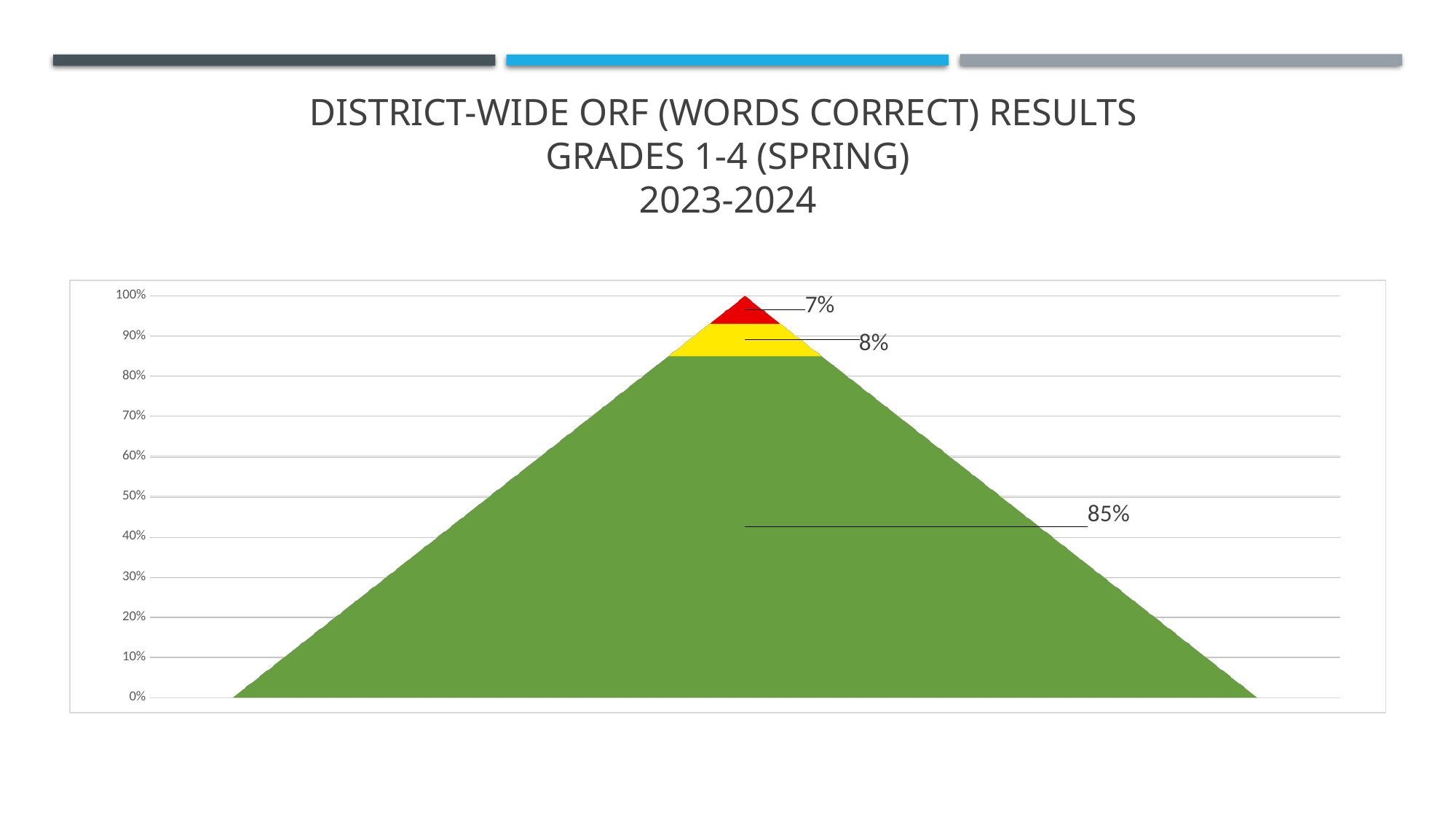
Which coloured segment has the largest value? green What is the difference between the yellow segment's value and the red segment's value? 1% What value is labelled on the red segment at the top of the pyramid? 7% What value is labelled on the green segment of the pyramid? 85% What school year does the chart title refer to? 2023-2024 How many coloured segments make up the pyramid? 3 What is the difference between the green segment's value and the yellow segment's value? 77% What is the highest value shown on the vertical axis? 100% What value is labelled on the yellow segment of the pyramid? 8% Which is larger, the yellow segment's value or the red segment's value? yellow Which coloured segment has the smallest value? red What is the total of the three labelled segments? 100%